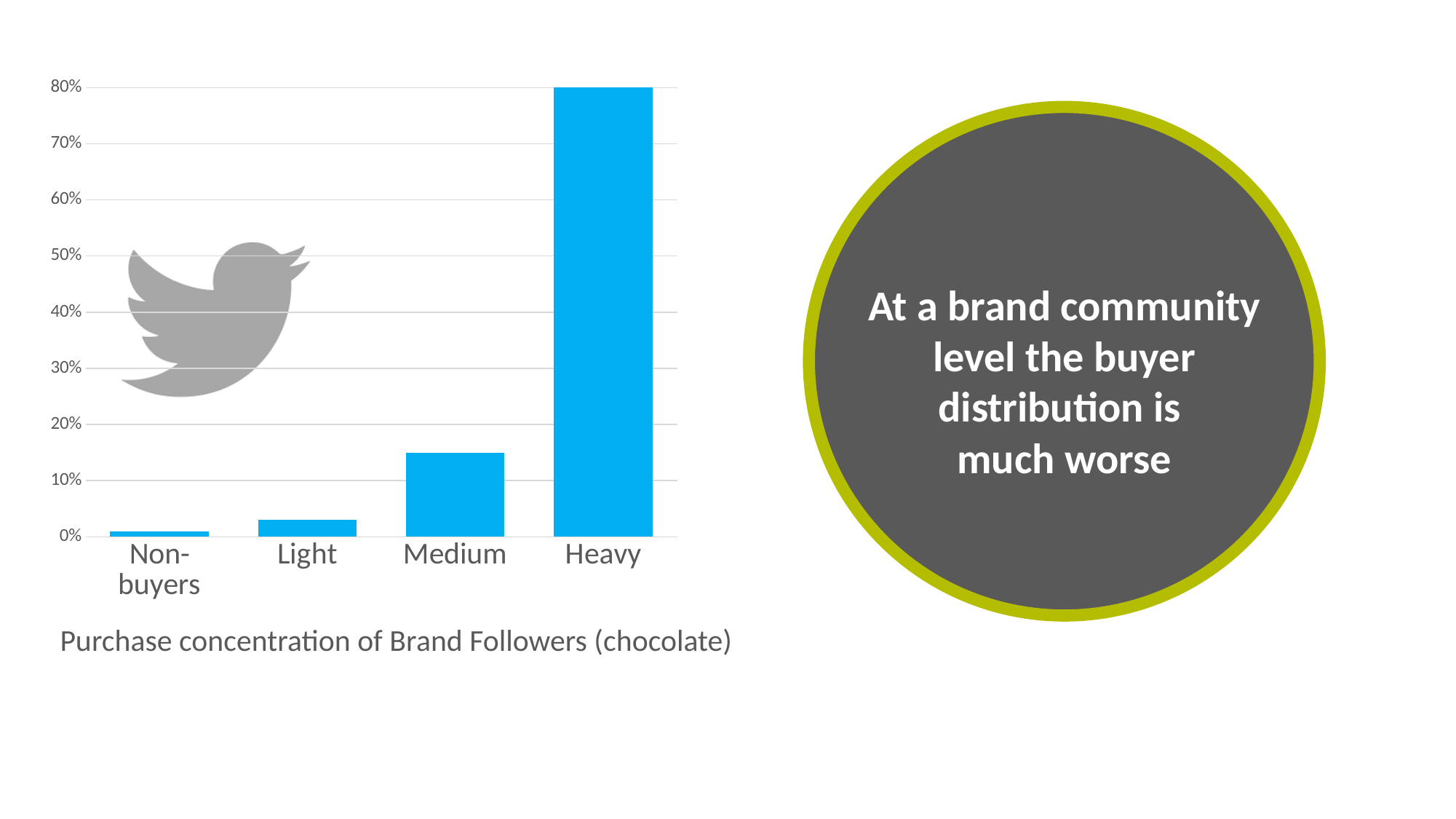
Which category has the highest value in the chart? Heavy Which category has the lowest value in the chart? Non-buyers Do the values rise or fall moving from Non-buyers to Heavy along the x axis? rise Is the value for Medium greater or less than 10%? greater What kind of chart is shown on the slide? bar chart What is the title of the chart? Purchase concentration of Brand Followers (chocolate) How many categories are shown on the x axis of the chart? 4 What is the highest value shown on the chart's y axis? 80% Is the value for Medium greater or less than 20%? less Is the value for Light greater or less than 10%? less Which is larger, the value for Medium or the value for Light? Medium What is the value for Heavy in the chart? 80%